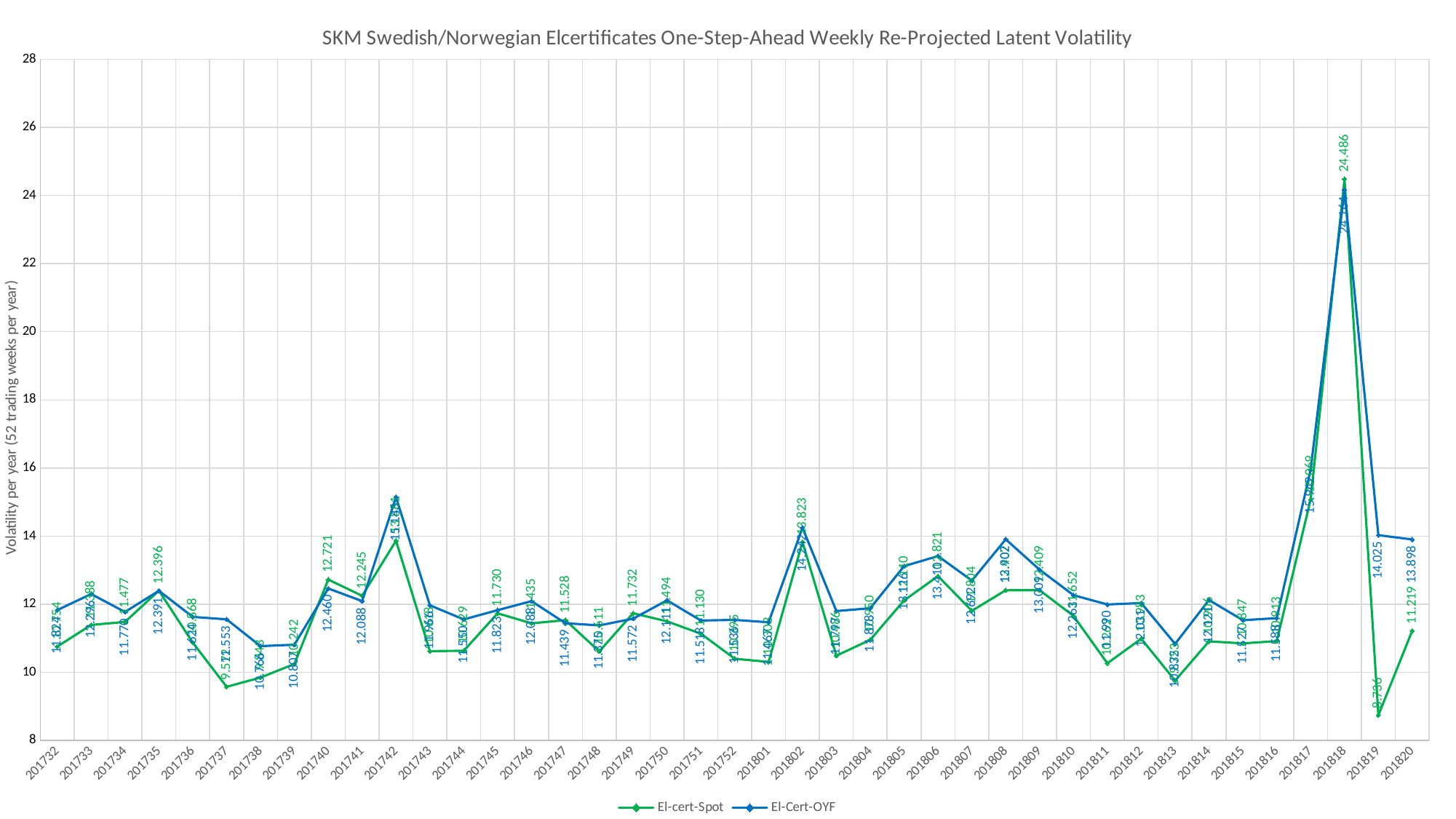
What is the El-cert-Spot value at 201818? 24.486 At 201740, which series has the larger value, El-cert-Spot or El-Cert-OYF? El-cert-Spot How many series does the legend list? 2 What is the El-cert-Spot value at 201820? 11.219 How many weekly points are plotted along the x axis? 41 What kind of chart is shown on the slide? Line chart What is the El-Cert-OYF value at 201819? 14.025 Is the El-cert-Spot value at 201819 greater or less than 10? less At which week does El-cert-Spot reach its highest value? 201818 What is the El-cert-Spot value at 201740? 12.721 What is the difference between El-Cert-OYF and El-cert-Spot at 201820? 2.679 At which week does El-cert-Spot reach its lowest value? 201819